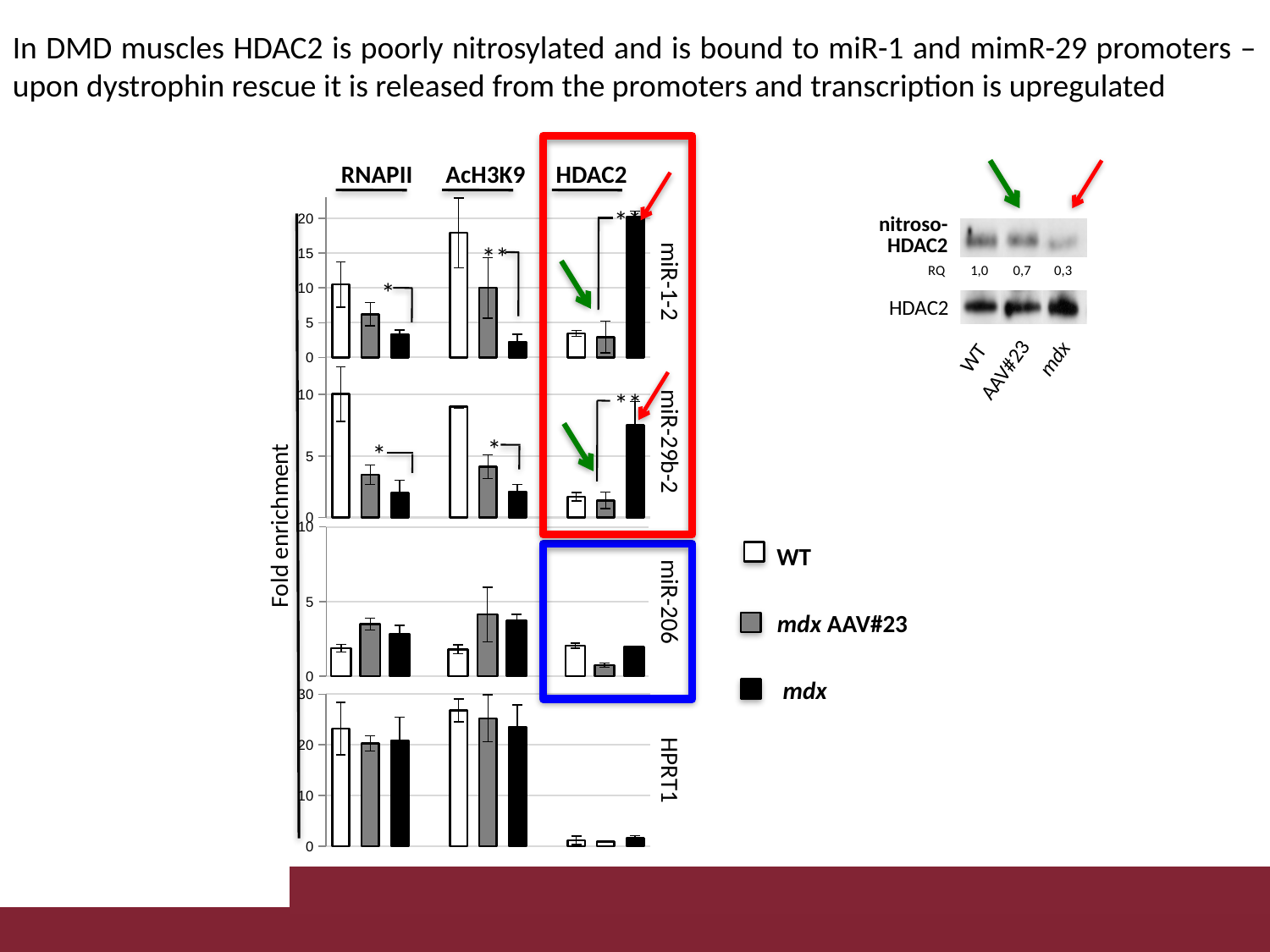
In the HPRT1 panel, is the RNAPII value for WT greater or less than 20? greater What kind of chart is shown on the left of the slide? bar chart How many antibody groups (column headings) are shown across the top of the bar chart? 3 In the miR-1-2 panel, which is larger in the RNAPII group: the WT bar or the mdx bar? WT In the miR-1-2 panel, which series has the highest bar in the HDAC2 group? mdx How many series does the legend of the bar chart list? 3 What are the three series named in the legend of the bar chart? WT, mdx AAV#23, mdx In the miR-1-2 panel, is the RNAPII value for WT greater or less than 5? greater What is the label on the y axis of the bar chart? Fold enrichment In the miR-29b-2 panel, which series has the highest bar in the HDAC2 group? mdx How many gene panels (rows) does the bar chart contain? 4 In the miR-1-2 panel, is the HDAC2 value for mdx greater or less than 15? greater